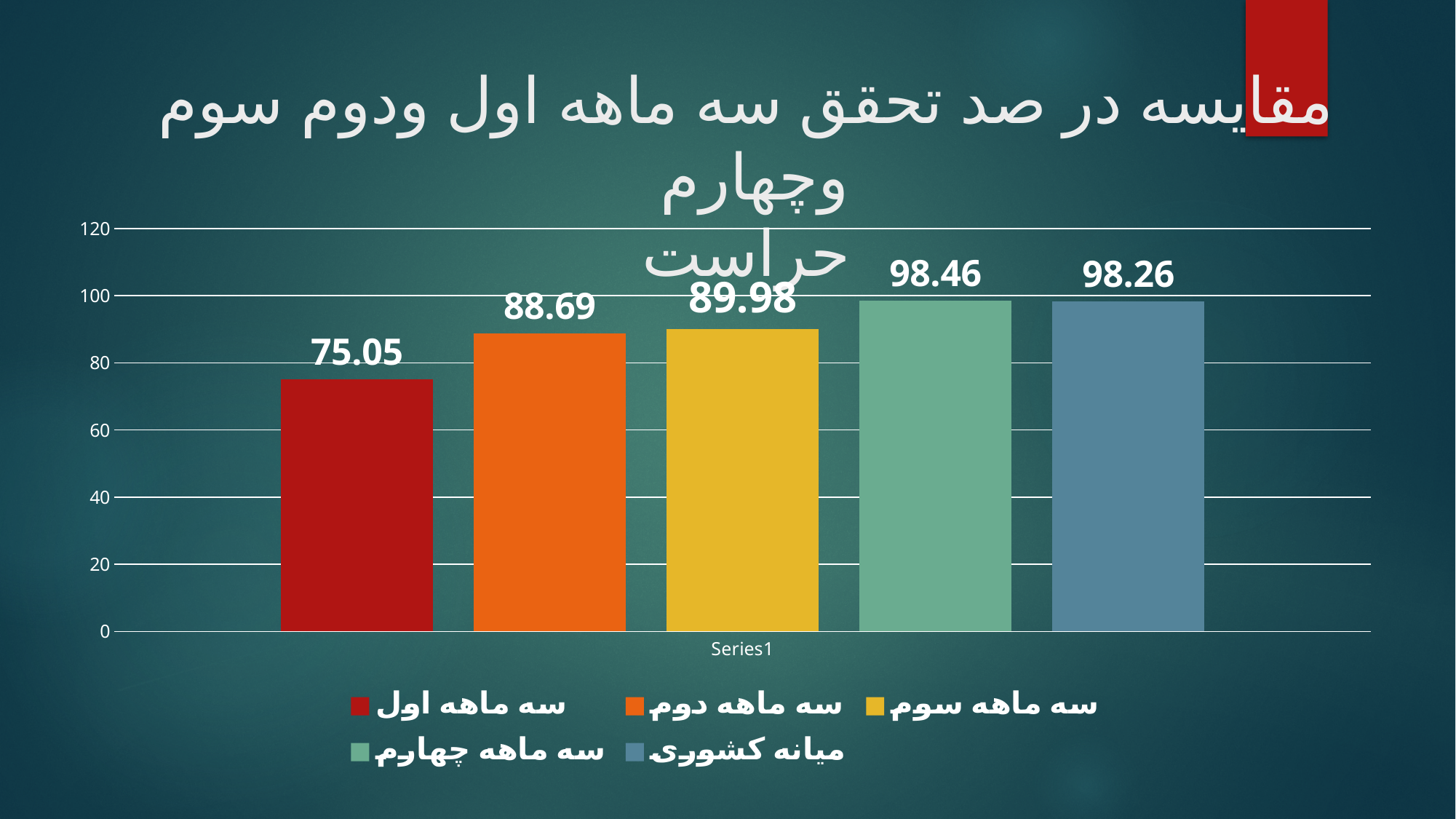
How many bars are plotted in the chart? 5 What is the value for سه ماهه سوم? 89.98 Which category has the lowest value? سه ماهه اول Which category has the highest value? سه ماهه چهارم What is the value for سه ماهه چهارم? 98.46 What is the value for میانه کشوری? 98.26 What is the value for سه ماهه اول? 75.05 What kind of chart is shown on the slide? bar chart What is the difference between the values for سه ماهه چهارم and سه ماهه اول? 23.41 Which is larger, the value for سه ماهه سوم or سه ماهه دوم? سه ماهه سوم What is the value for سه ماهه دوم? 88.69 Is the value for سه ماهه اول greater or less than 80? less